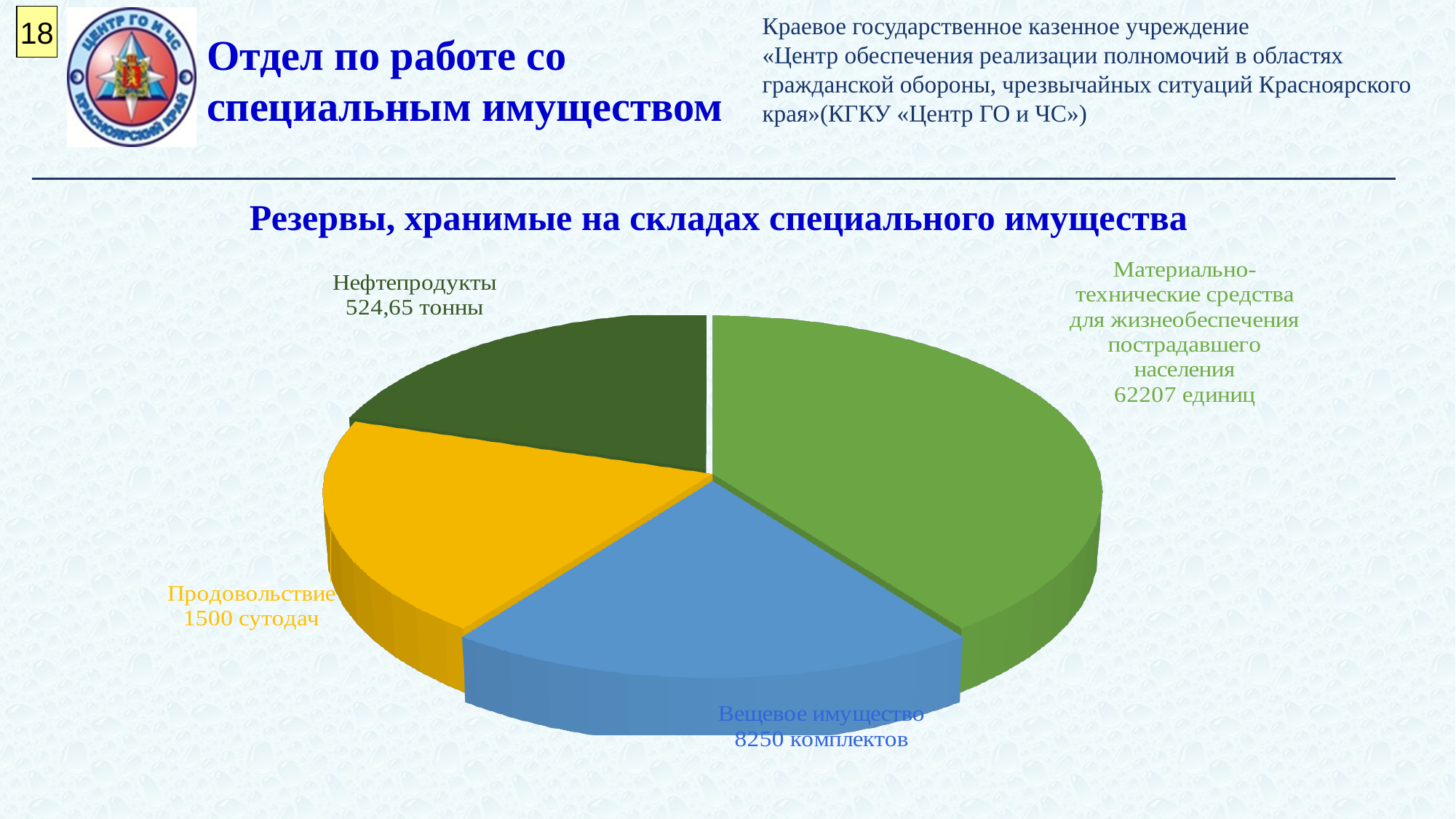
What value is shown for Вещевое имущество? 8250 комплектов What kind of chart is shown on the slide? Pie chart What colour is the slice for Продовольствие? Yellow Which category occupies the largest slice of the pie? Материально-технические средства для жизнеобеспечения пострадавшего населения What value is shown for Продовольствие? 1500 сутодач What value is shown for Нефтепродукты? 524,65 тонны How many slices does the pie chart have? 4 What value is shown for Материально-технические средства для жизнеобеспечения пострадавшего населения? 62207 единиц What is the title of the chart? Резервы, хранимые на складах специального имущества